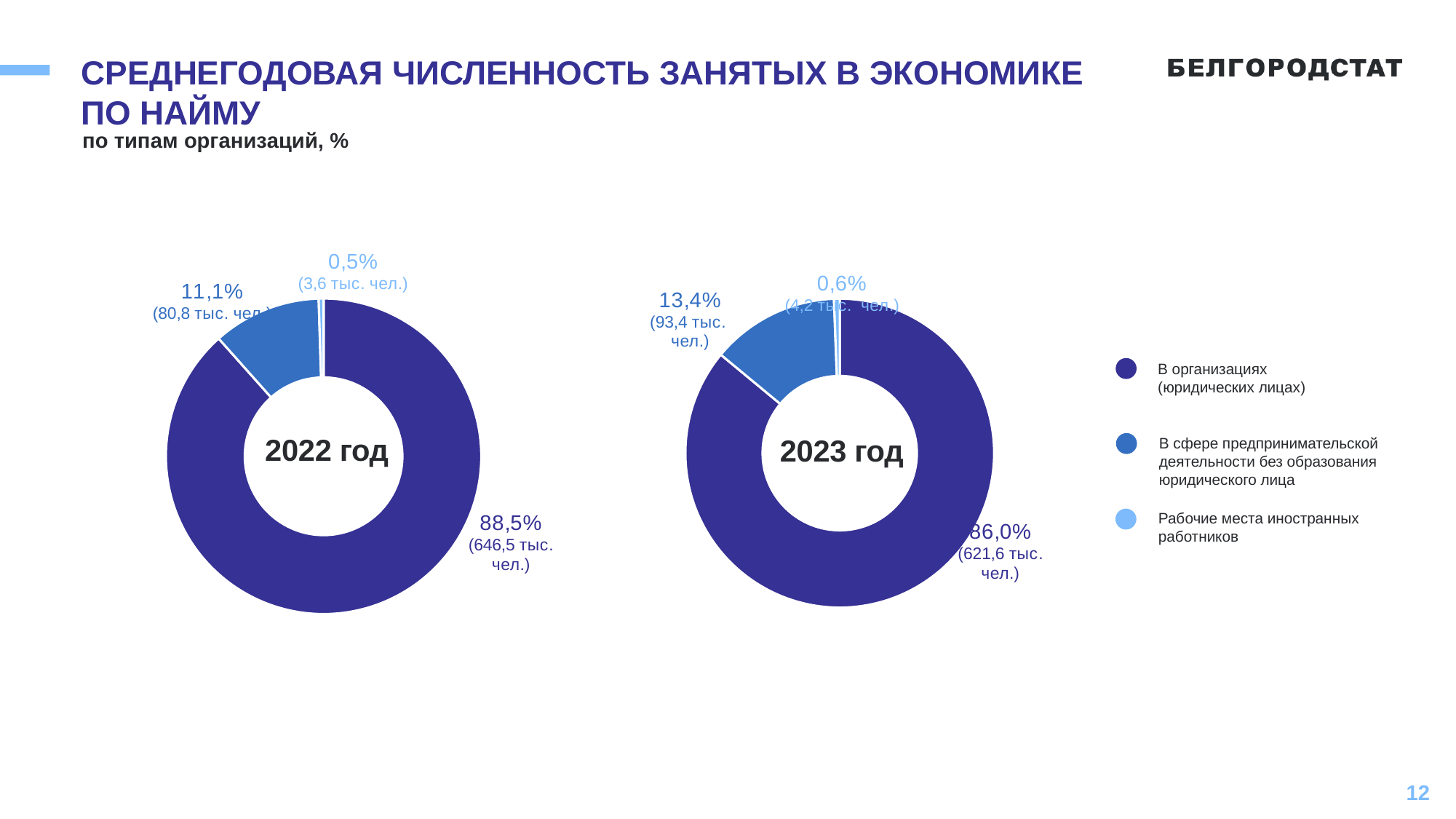
На диаграмме «2022 год» какая категория имеет наименьшую долю? Рабочие места иностранных работников Какой год указан в центре правой диаграммы? 2023 год На сколько процентных пунктов доля категории «В сфере предпринимательской деятельности без образования юридического лица» на диаграмме «2023 год» больше, чем на диаграмме «2022 год»? 2,3 Сколько записей содержит легенда на слайде? 3 На диаграмме «2023 год» какая категория имеет наибольшую долю? В организациях (юридических лицах) На диаграмме «2022 год» какая доля приходится на категорию «В организациях (юридических лицах)»? 88,5% Какого типа диаграммы показаны на слайде? Кольцевые (круговые) диаграммы На диаграмме «2023 год» сколько тысяч человек указано для категории «В организациях (юридических лицах)»? 621,6 тыс. чел. Где доля категории «В организациях (юридических лицах)» больше: на диаграмме «2022 год» или «2023 год»? 2022 год Сколько категорий показано на диаграмме «2022 год»? 3 На диаграмме «2022 год» сколько тысяч человек указано для категории «Рабочие места иностранных работников»? 3,6 тыс. чел. На диаграмме «2023 год» какая доля приходится на категорию «В сфере предпринимательской деятельности без образования юридического лица»? 13,4%